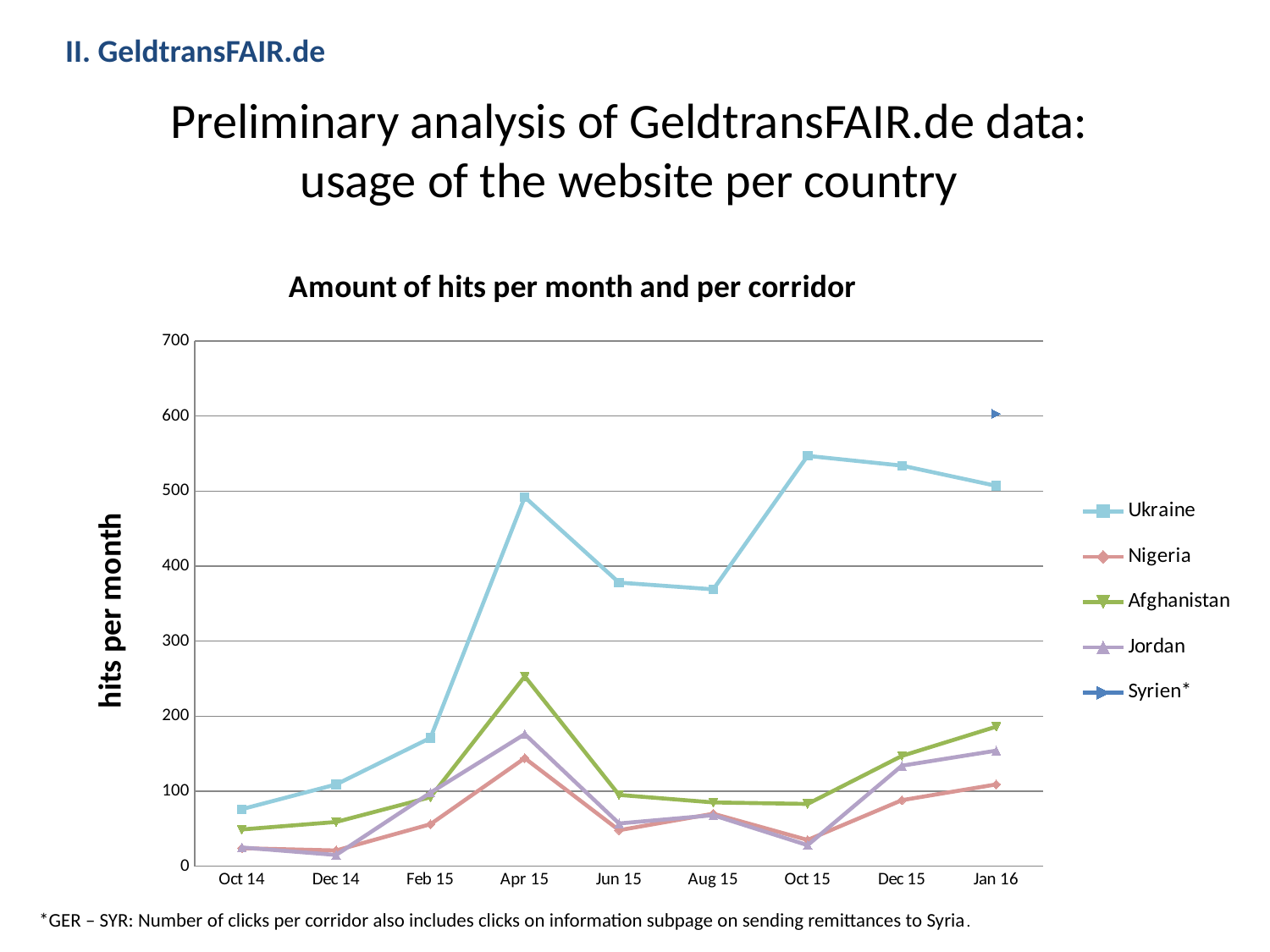
Is the value for Afghanistan at Apr 15 greater or less than 200? greater What is the title of the chart? Amount of hits per month and per corridor How many month labels are shown on the x axis? 9 What kind of chart is shown on the slide? line chart At Jan 16, which is larger: the value for Afghanistan or the value for Nigeria? Afghanistan Which month has the lowest value for Ukraine? Oct 14 Which series has the highest value at Apr 15? Ukraine Is the value for Syrien* at Jan 16 greater or less than 500? greater Is the value for Nigeria at Jun 15 greater or less than 100? less Does the Ukraine line rise or fall from Oct 15 to Jan 16? fall How many series does the legend list? 5